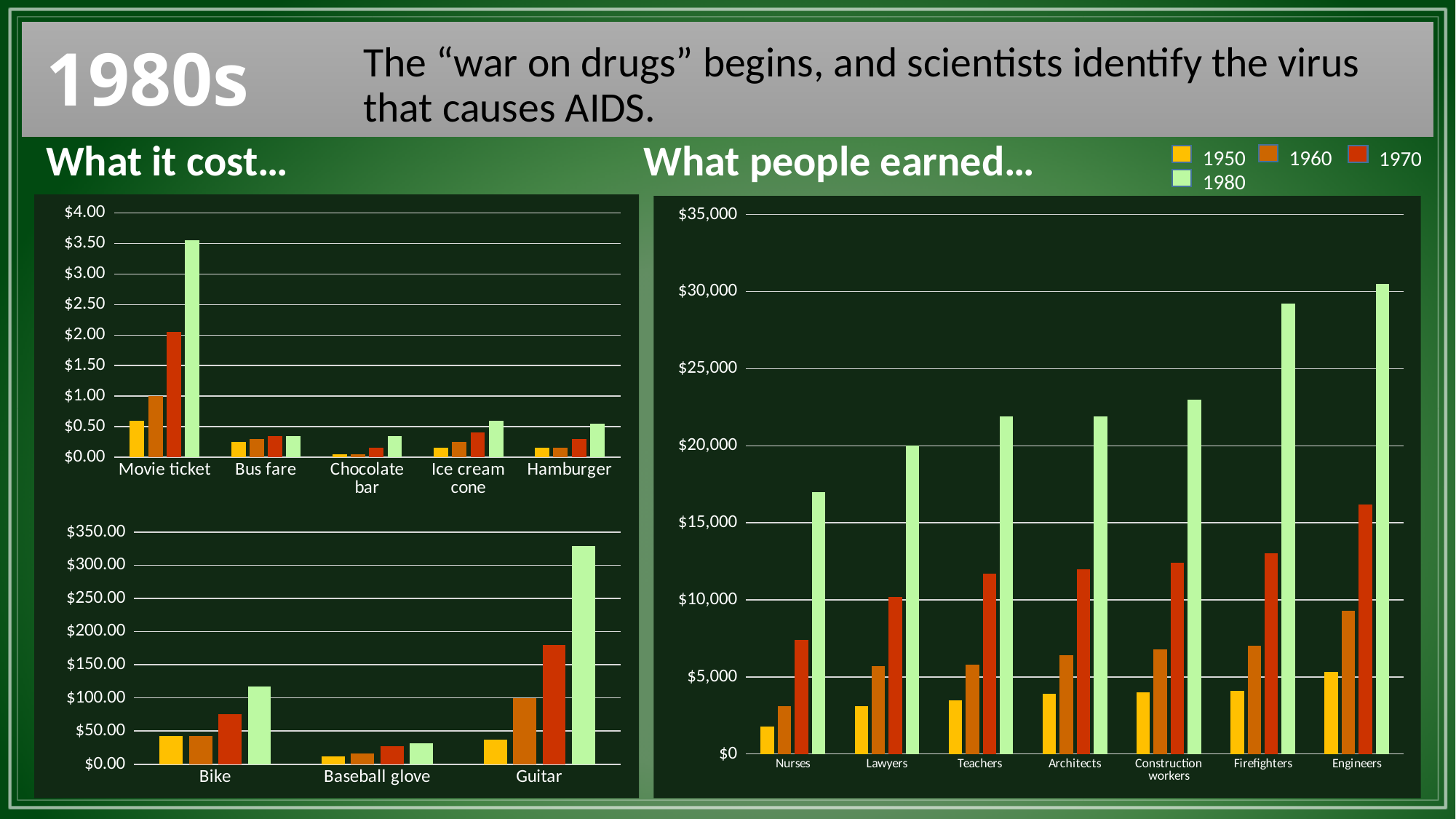
On the 'What people earned...' chart, is the 1970 value for Engineers greater or less than $15,000? greater On the 'What people earned...' chart, do the values for Nurses rise or fall from 1950 to 1980? rise On the 'What people earned...' chart, which occupation has the highest 1980 value? Engineers On the top-left 'What it cost...' chart, is the 1980 value for Movie ticket greater or less than $3.00? greater On the 'What people earned...' chart, how many occupations are shown on the x axis? 7 On the bottom-left 'What it cost...' chart, which item has the highest 1980 value? Guitar On the bottom-left 'What it cost...' chart, is the 1980 value for Baseball glove greater or less than $50.00? less What kind of chart is the 'What people earned...' chart? bar chart On the 'What people earned...' chart, how many series does the legend list? 4 On the top-left 'What it cost...' chart, how many items are shown on the x axis? 5